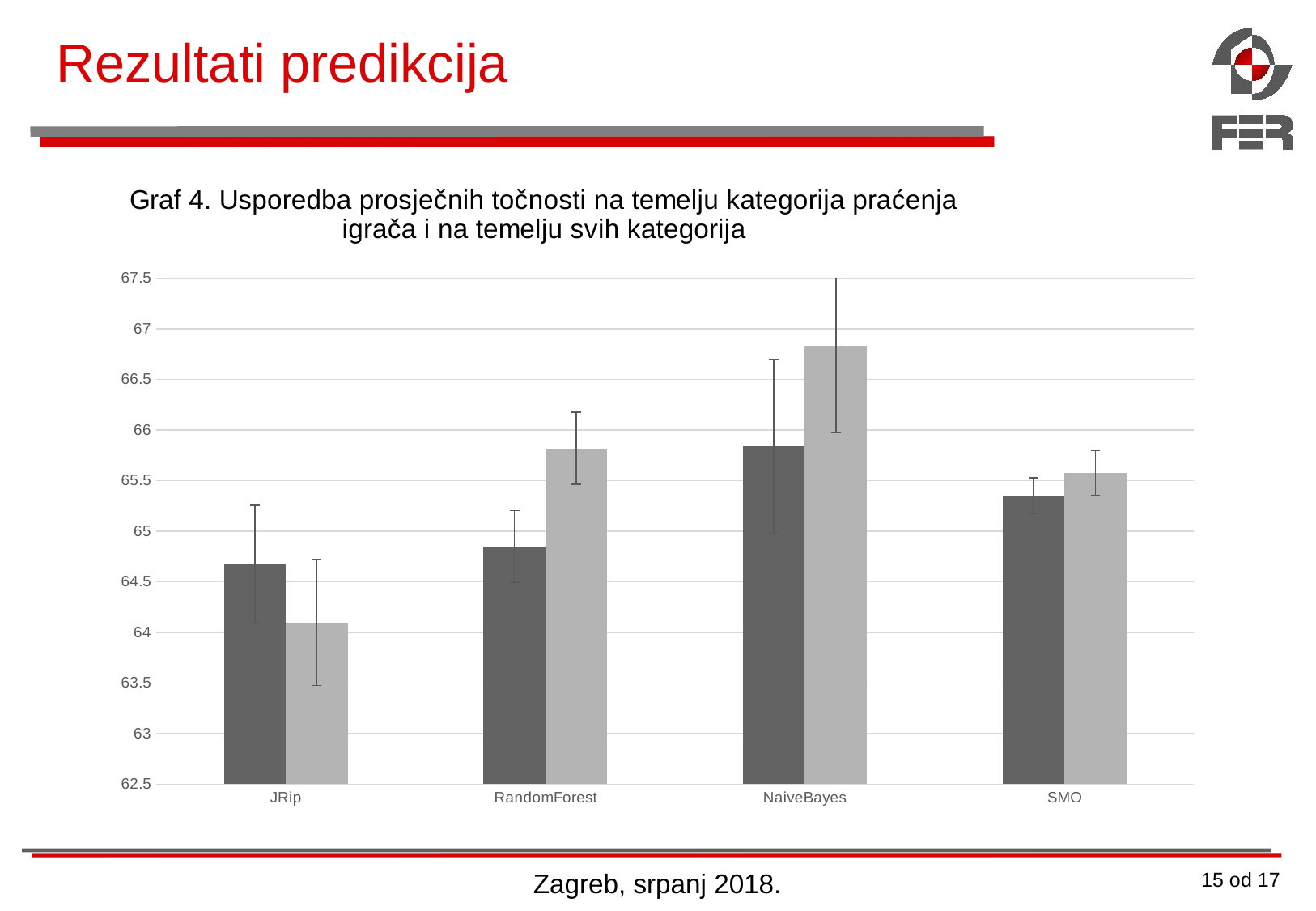
What is the title of the chart? Graf 4. Usporedba prosječnih točnosti na temelju kategorija praćenja igrača i na temelju svih kategorija Is the value of the dark grey bar for JRip greater or less than 65? less Is the value of the dark grey bar for NaiveBayes greater or less than 65.5? greater Is the value of the light grey bar for RandomForest greater or less than 65.5? greater For RandomForest, which bar is taller, the dark grey bar or the light grey bar? the light grey bar How many categories are shown on the x axis of the chart? 4 For JRip, which bar is taller, the dark grey bar or the light grey bar? the dark grey bar Which category has the shortest bar in the chart? JRip Which category has the tallest bar in the chart? NaiveBayes What kind of chart is shown on the slide? bar chart